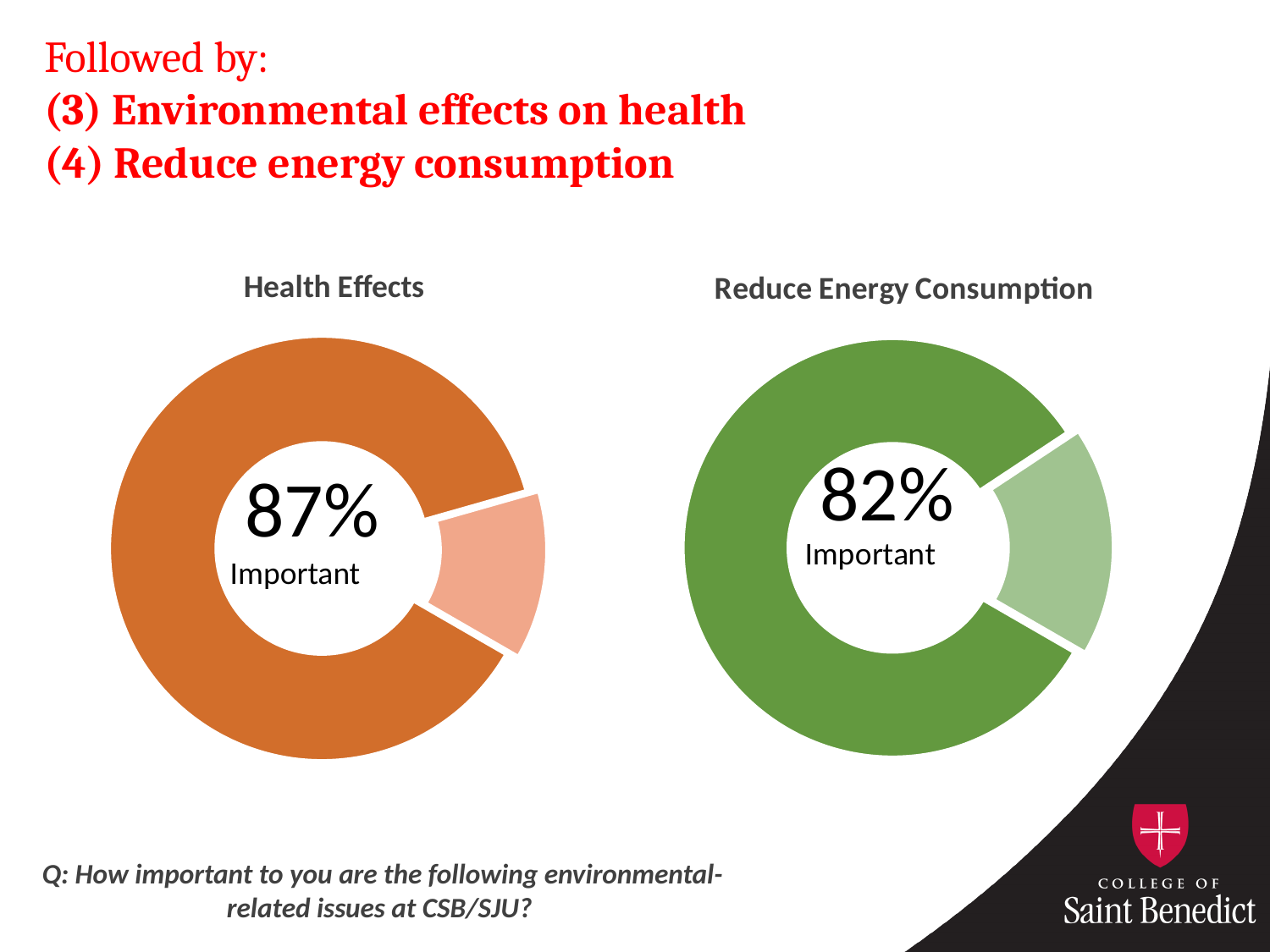
Which chart shows a higher share rated important, Health Effects or Reduce Energy Consumption? Health Effects What kind of chart is the Health Effects chart? Donut (pie) chart How many slices does the Health Effects chart have? 2 What kind of chart is the Reduce Energy Consumption chart? Donut (pie) chart In the Reduce Energy Consumption chart, what share of the pie is the smaller, light-coloured slice? 18% What is the difference between the important share in the Health Effects chart and the important share in the Reduce Energy Consumption chart? 5% What is the title of the chart on the left side of the slide? Health Effects What colour is the large slice in the Reduce Energy Consumption chart? Green In the Reduce Energy Consumption chart, what percentage of respondents rated the issue as important? 82% In the Health Effects chart, what percentage of respondents rated the issue as important? 87% How many slices does the Reduce Energy Consumption chart have? 2 In the Health Effects chart, what share of the pie is the smaller, light-coloured slice? 13%